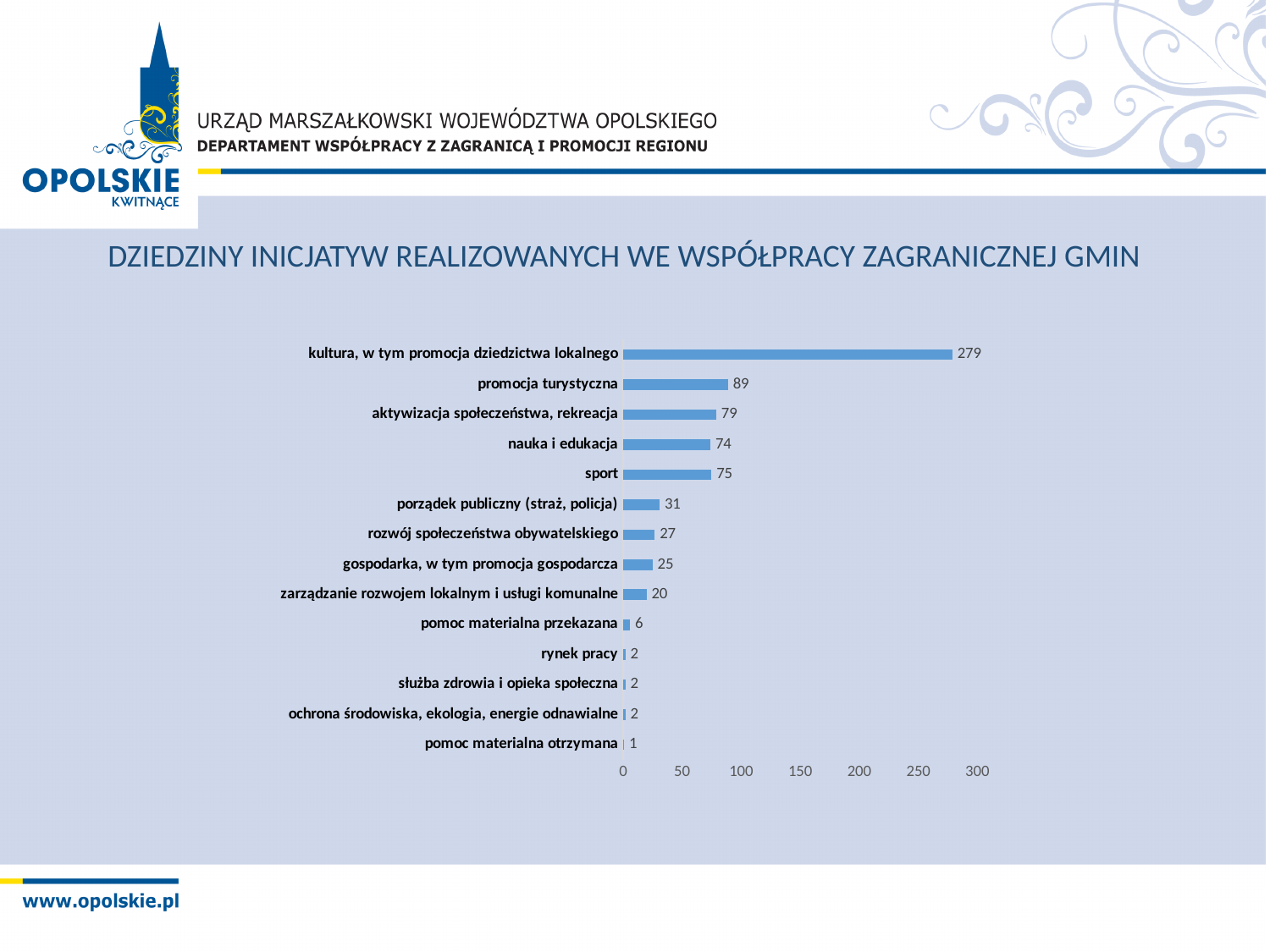
Which category has the lowest value? pomoc materialna otrzymana What is the difference between the values for "sport" and "nauka i edukacja"? 1 Which category has the highest value? kultura, w tym promocja dziedzictwa lokalnego What is the value for "promocja turystyczna"? 89 What kind of chart is shown on the slide? bar chart What is the difference between the values for "kultura, w tym promocja dziedzictwa lokalnego" and "promocja turystyczna"? 190 Is the value for "kultura, w tym promocja dziedzictwa lokalnego" greater or less than 250? greater What is the value for "kultura, w tym promocja dziedzictwa lokalnego"? 279 Which is larger, the value for "aktywizacja społeczeństwa, rekreacja" or the value for "gospodarka, w tym promocja gospodarcza"? aktywizacja społeczeństwa, rekreacja How many categories are shown in the chart? 14 What is the value for "porządek publiczny (straż, policja)"? 31 What is the title of the chart? DZIEDZINY INICJATYW REALIZOWANYCH WE WSPÓŁPRACY ZAGRANICZNEJ GMIN